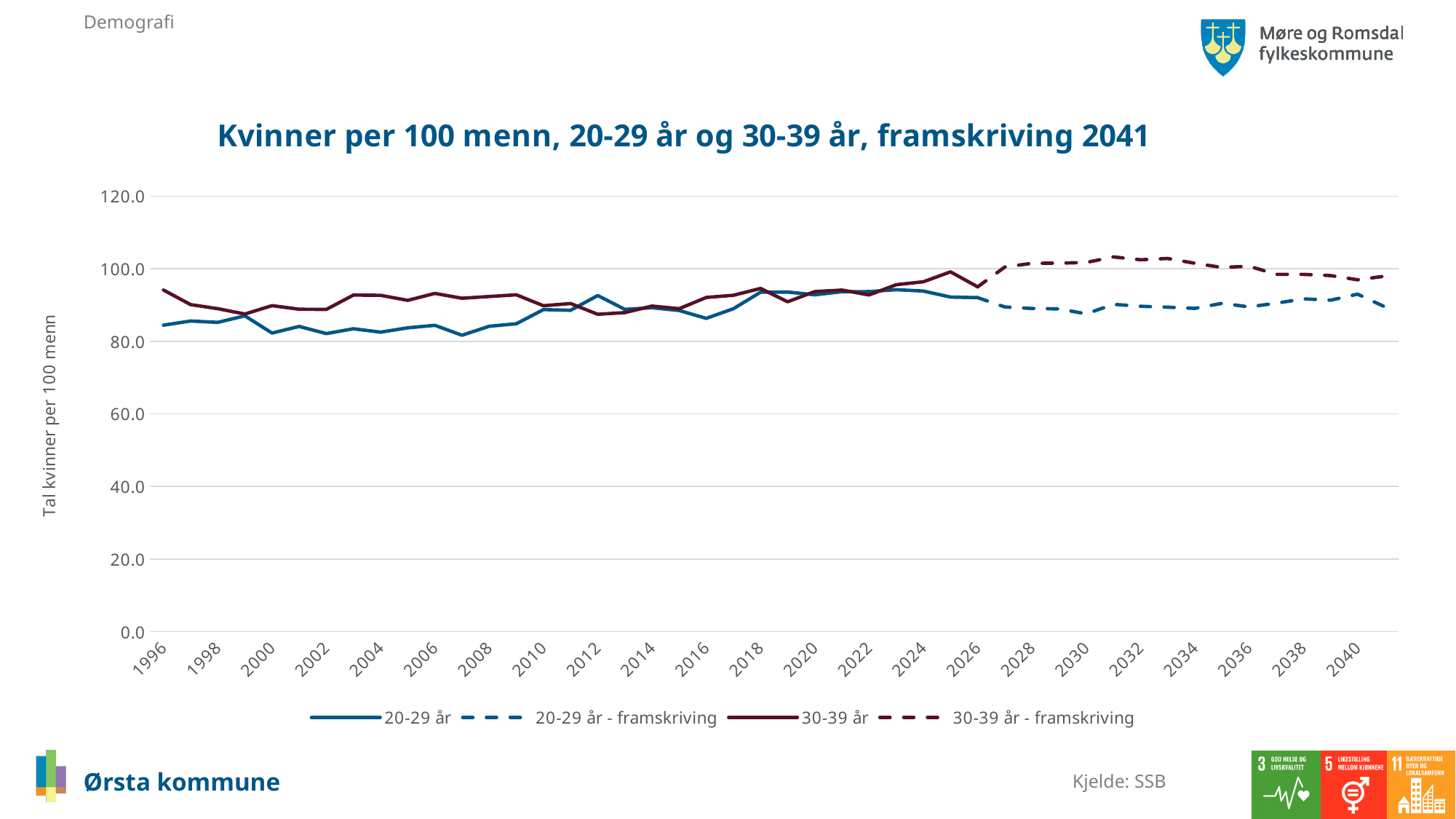
Is the value for 30-39 år in 1996 greater or less than 80? greater In 2032, which series has the higher value, 20-29 år - framskriving or 30-39 år - framskriving? 30-39 år - framskriving Does the 20-29 år series overall rise or fall from 1996 to 2026? rise What kind of chart is shown on the slide? line chart What is the title of the chart? Kvinner per 100 menn, 20-29 år og 30-39 år, framskriving 2041 Is the value for 20-29 år in 1996 greater or less than 100? less How many series does the legend list? 4 Which series reaches the highest value anywhere on the chart? 30-39 år - framskriving Is the value for 20-29 år - framskriving in 2030 greater or less than 100? less What is the label on the vertical axis? Tal kvinner per 100 menn In 1996, which series has the higher value, 20-29 år or 30-39 år? 30-39 år